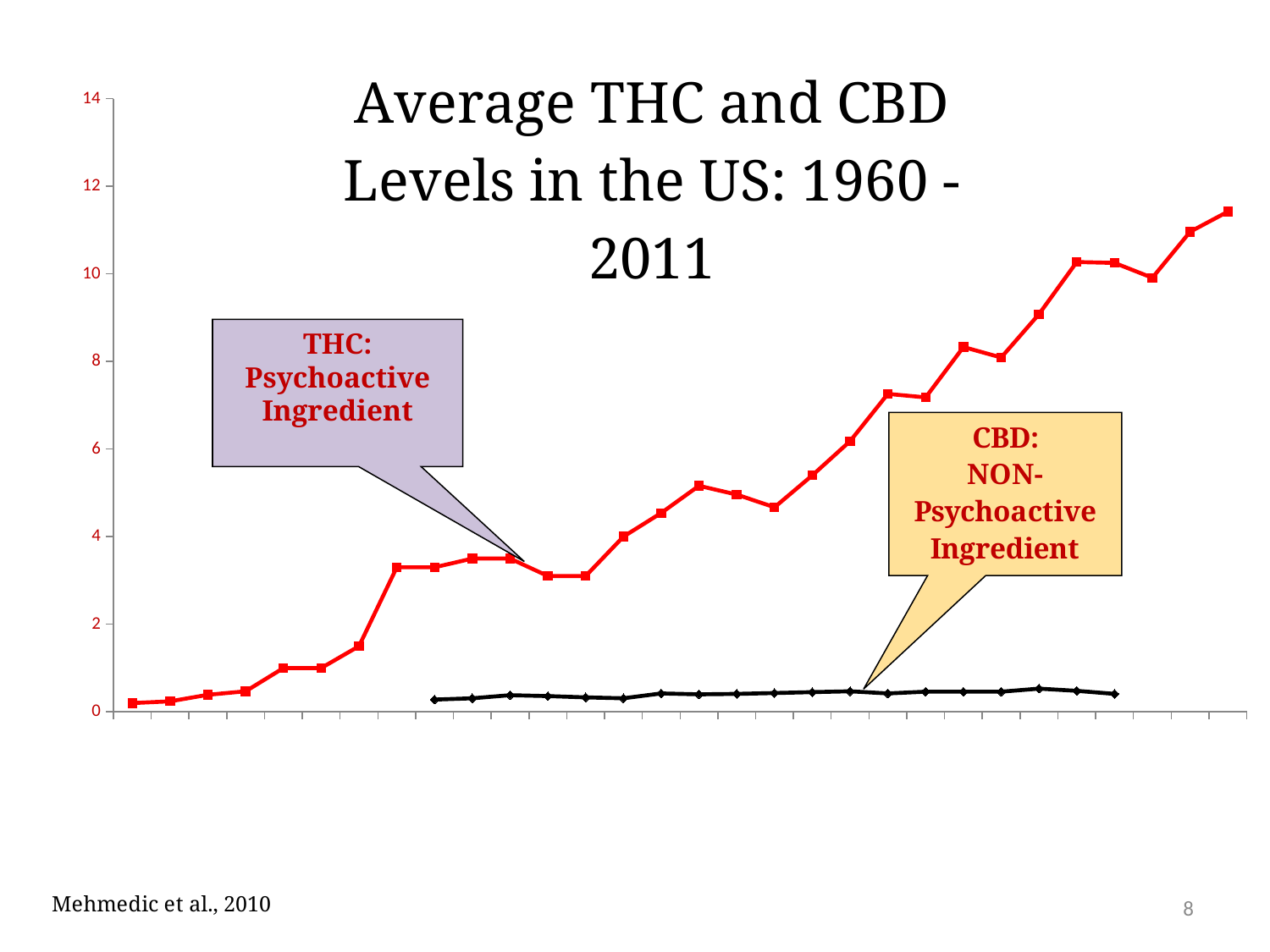
Does the THC line generally rise or fall from left to right? rise What is the title of the chart? Average THC and CBD Levels in the US: 1960 - 2011 What is the maximum value shown on the vertical axis? 14 Which series is drawn in red? THC Which series stays lowest across the chart? CBD Is the last (rightmost) THC value greater or less than 10? greater Is the highest CBD value greater or less than 2? less Which series reaches the highest value on the chart? THC Is the last (rightmost) THC value greater or less than 12? less What kind of chart is shown on the slide? line chart At the right end of the chart, which series has the larger value, THC or CBD? THC